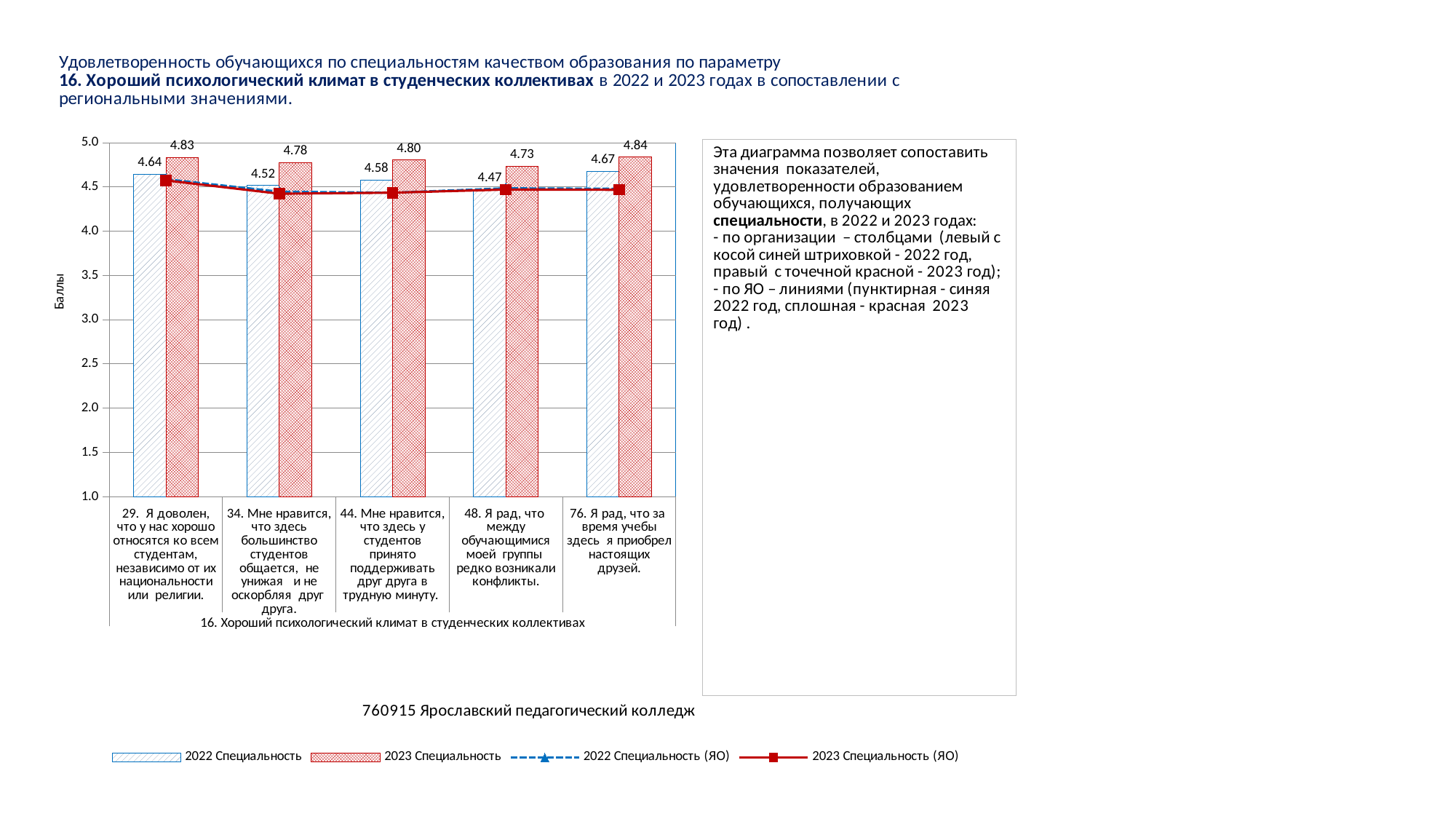
What is the label of the y axis? Баллы How many items (categories) are shown on the x axis? 5 Which item has the highest 2023 Специальность value? 76. Я рад, что за время учебы здесь я приобрел настоящих друзей. What is the 2022 Специальность value for item 29 (Я доволен, что у нас хорошо относятся ко всем студентам)? 4.64 What is the 2023 Специальность value for item 76 (Я рад, что за время учебы здесь я приобрел настоящих друзей)? 4.84 What is the 2023 Специальность value for item 48 (Я рад, что между обучающимися моей группы редко возникали конфликты)? 4.73 What kind of chart is this? Combined bar and line chart How many series does the legend list? 4 Which item has the lowest 2022 Специальность value? 48. Я рад, что между обучающимися моей группы редко возникали конфликты. Which is larger for item 44: the 2022 Специальность value or the 2023 Специальность value? 2023 Специальность What is the difference between the 2023 and 2022 Специальность values for item 34 (Мне нравится, что здесь большинство студентов общается, не унижая и не оскорбляя друг друга)? 0.26 Is the 2023 Специальность (ЯО) line value for item 34 greater or less than 4.5? less